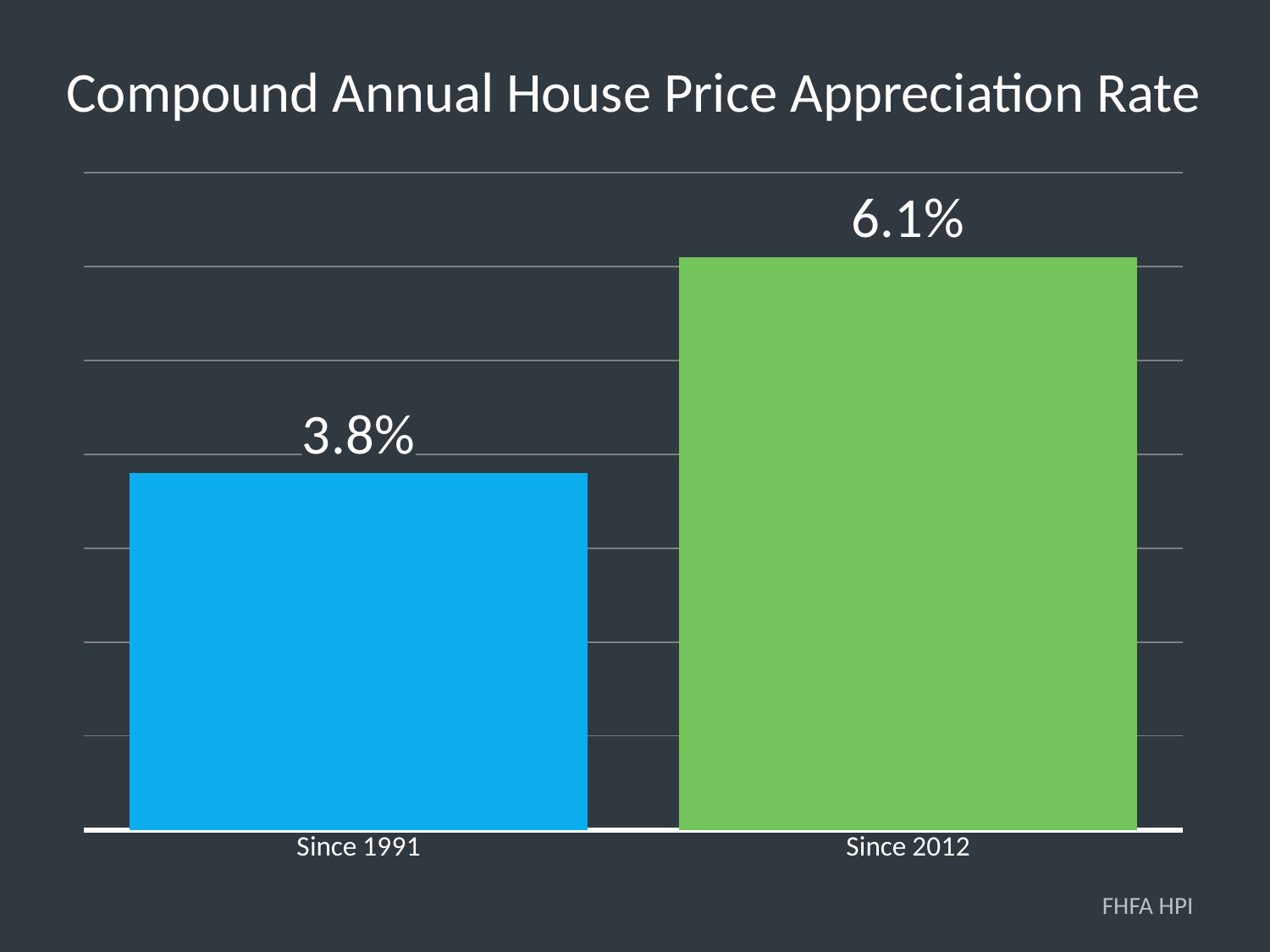
What is the compound annual house price appreciation rate since 2012? 6.1% Which period has the lower appreciation rate? Since 1991 What is the title of the chart? Compound Annual House Price Appreciation Rate What colour is the bar for Since 2012? green Is the appreciation rate since 1991 larger or smaller than the rate since 2012? smaller Which period has the higher appreciation rate? Since 2012 How many categories are shown on the chart? 2 What kind of chart is shown on the slide? bar chart What is the difference between the appreciation rate since 2012 and the rate since 1991? 2.3% What is the compound annual house price appreciation rate since 1991? 3.8%